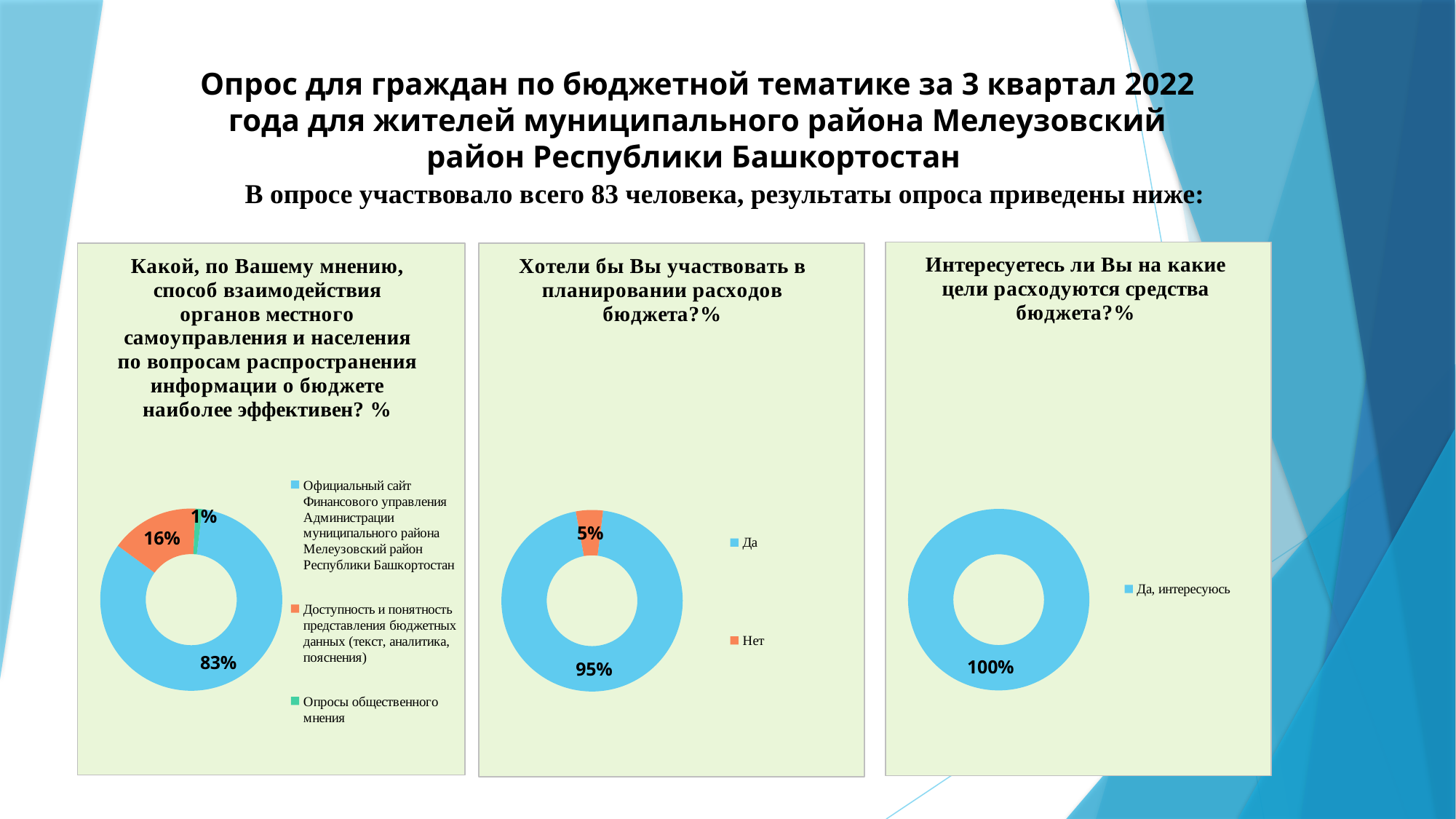
In the left chart, which category has the smallest share? Опросы общественного мнения In the middle chart, which is larger, the share for "Да" or the share for "Нет"? Да How many categories does the legend of the left chart list? 3 What type of chart is used in the middle panel of the slide? Doughnut chart In the left chart, what percentage is shown for "Доступность и понятность представления бюджетных данных (текст, аналитика, пояснения)"? 16% In the left chart, which category has the largest share? Официальный сайт Финансового управления Администрации муниципального района Мелеузовский район Республики Башкортостан In the middle chart ("Хотели бы Вы участвовать в планировании расходов бюджета?"), what percentage answered "Да"? 95% In the right chart ("Интересуетесь ли Вы на какие цели расходуются средства бюджета?"), what percentage is shown for "Да, интересуюсь"? 100% In the left chart, what percentage is shown for "Опросы общественного мнения"? 1% In the left chart, what is the difference in percentage points between the "Официальный сайт..." share and the "Доступность и понятность..." share? 67 In the middle chart, what percentage answered "Нет"? 5% In the left chart ("Какой, по Вашему мнению, способ взаимодействия..."), what percentage is shown for "Официальный сайт Финансового управления Администрации муниципального района Мелеузовский район Республики Башкортостан"? 83%